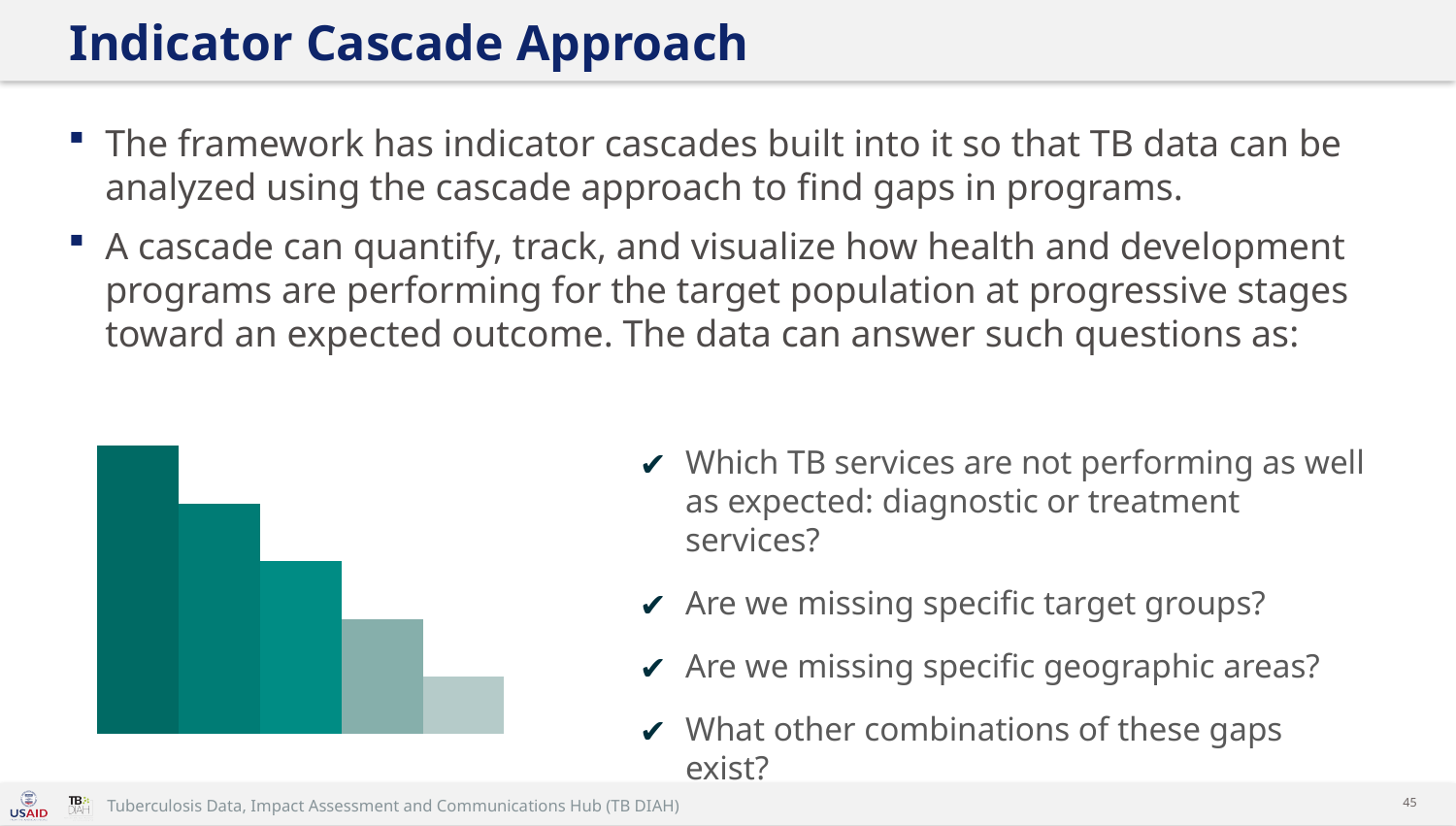
Does the chart on the left side of the slide show any axis labels or data values? No Do the bars in the chart on the left side of the slide rise or fall from left to right? fall How many bars does the chart on the left side of the slide contain? 5 Which bar in the chart on the left side of the slide is the tallest? the leftmost bar In the chart on the left side of the slide, is the second bar from the left taller or shorter than the fourth bar from the left? taller What colour family are the bars in the chart on the left side of the slide? teal/green shades Which bar in the chart on the left side of the slide is the shortest? the rightmost bar What kind of chart is shown on the left side of the slide? bar chart